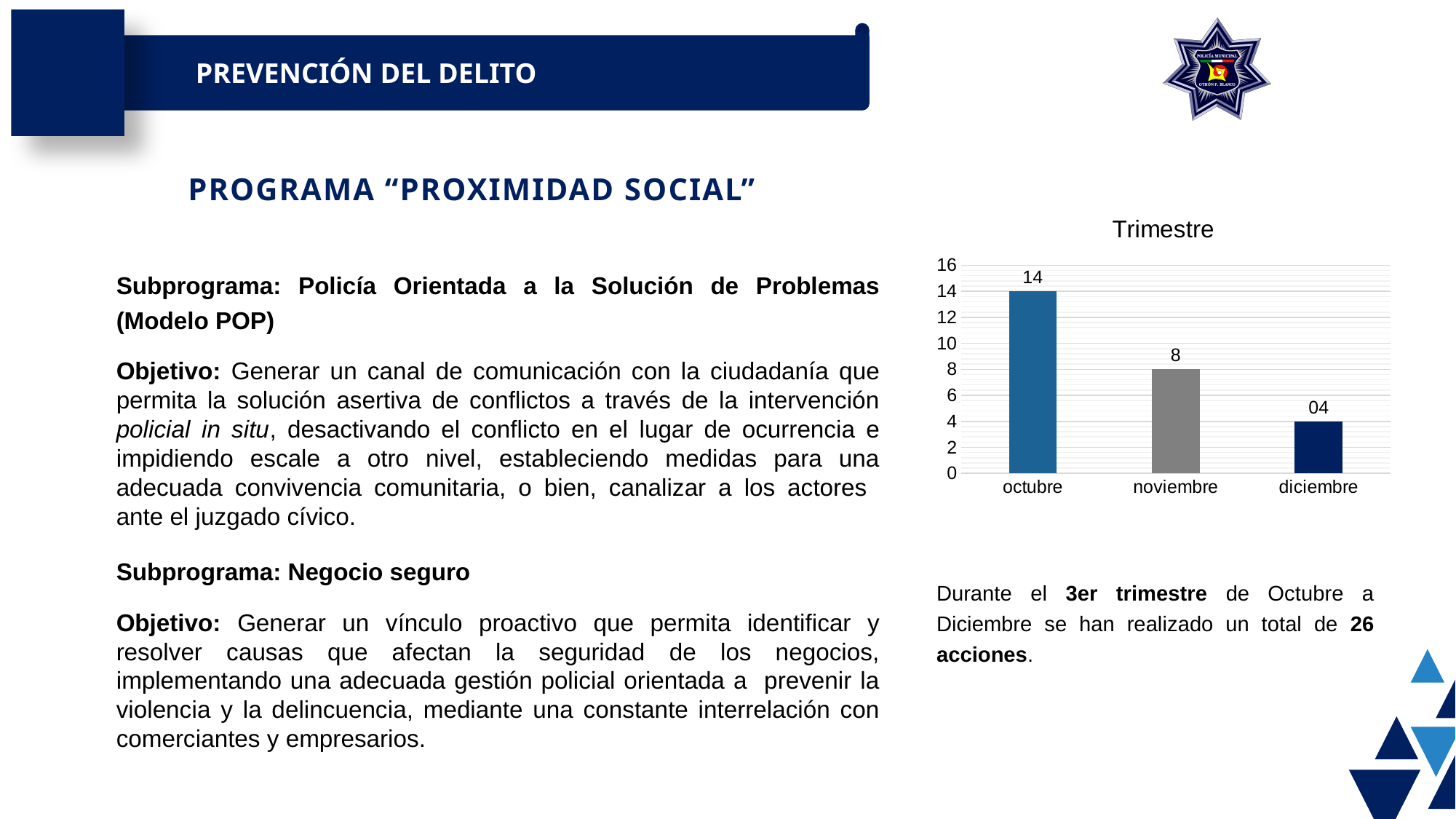
What is the difference between the values for octubre and noviembre in the Trimestre chart? 6 Is the value for noviembre in the Trimestre chart greater or less than 10? less Which month has the highest value in the Trimestre chart? octubre Do the values in the Trimestre chart rise or fall from octubre to diciembre? fall What kind of chart is the Trimestre chart? bar chart Which is larger in the Trimestre chart, the value for octubre or the value for diciembre? octubre What is the difference between the values for noviembre and diciembre in the Trimestre chart? 4 What is the data label shown for diciembre in the Trimestre chart? 04 Which month has the lowest value in the Trimestre chart? diciembre How many months are shown on the x axis of the Trimestre chart? 3 What is the value for noviembre in the Trimestre chart? 8 What is the value for octubre in the Trimestre chart? 14